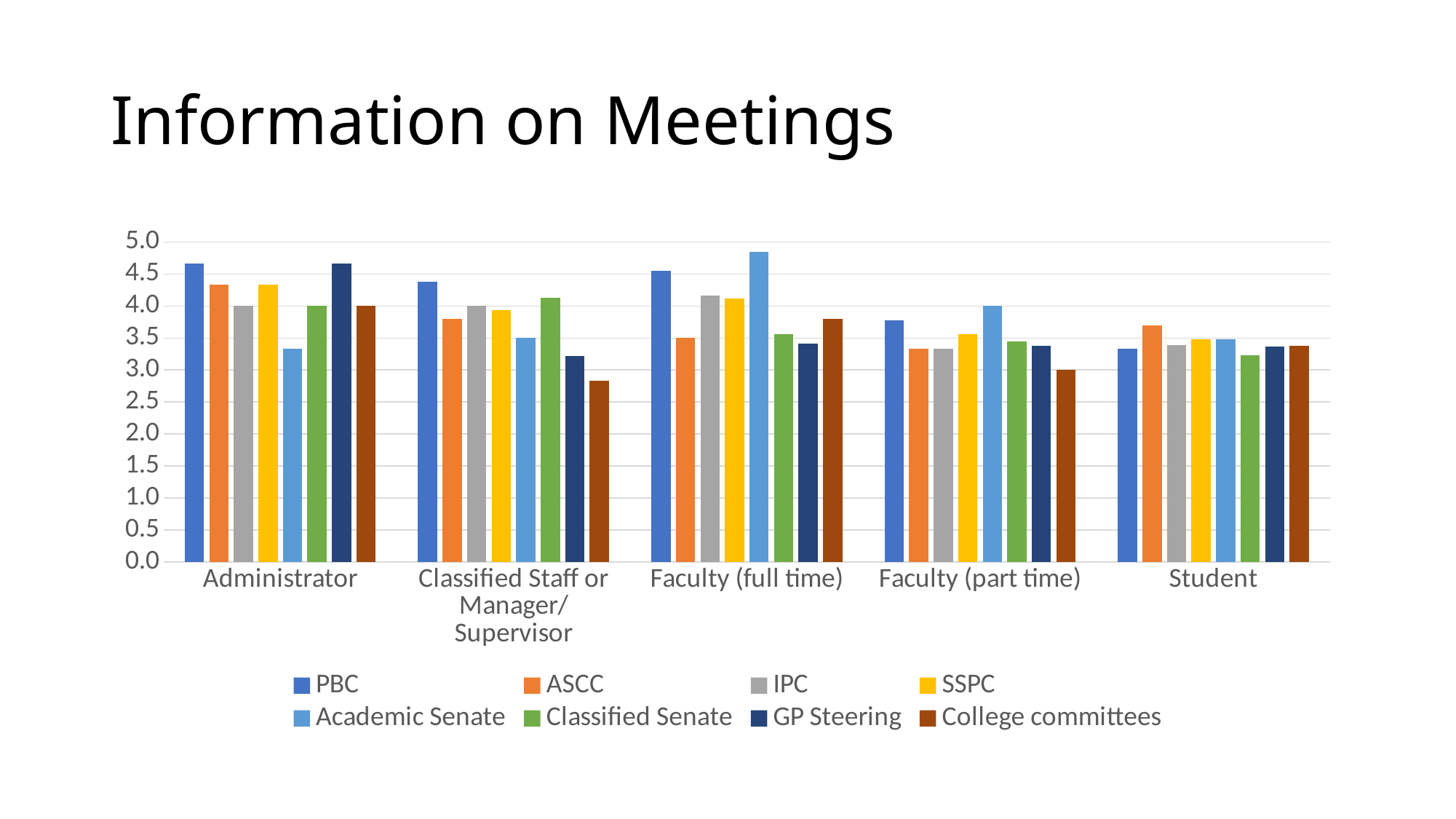
Which series has the lowest value for Classified Staff or Manager/Supervisor? College committees Which series has the highest value for Faculty (full time)? Academic Senate Which series has the lowest value for Faculty (part time)? College committees How many series does the legend list? 8 For Administrator, which is larger: PBC or Academic Senate? PBC What is the title of the slide? Information on Meetings What kind of chart is shown on the slide? bar chart Is the value for PBC in the Faculty (full time) category greater or less than 4.0? greater For Faculty (part time), which is larger: Academic Senate or College committees? Academic Senate How many categories are shown along the x axis? 5 Is the value for Academic Senate in the Administrator category greater or less than 3.5? less Is the value for College committees in the Classified Staff or Manager/Supervisor category greater or less than 3.0? less